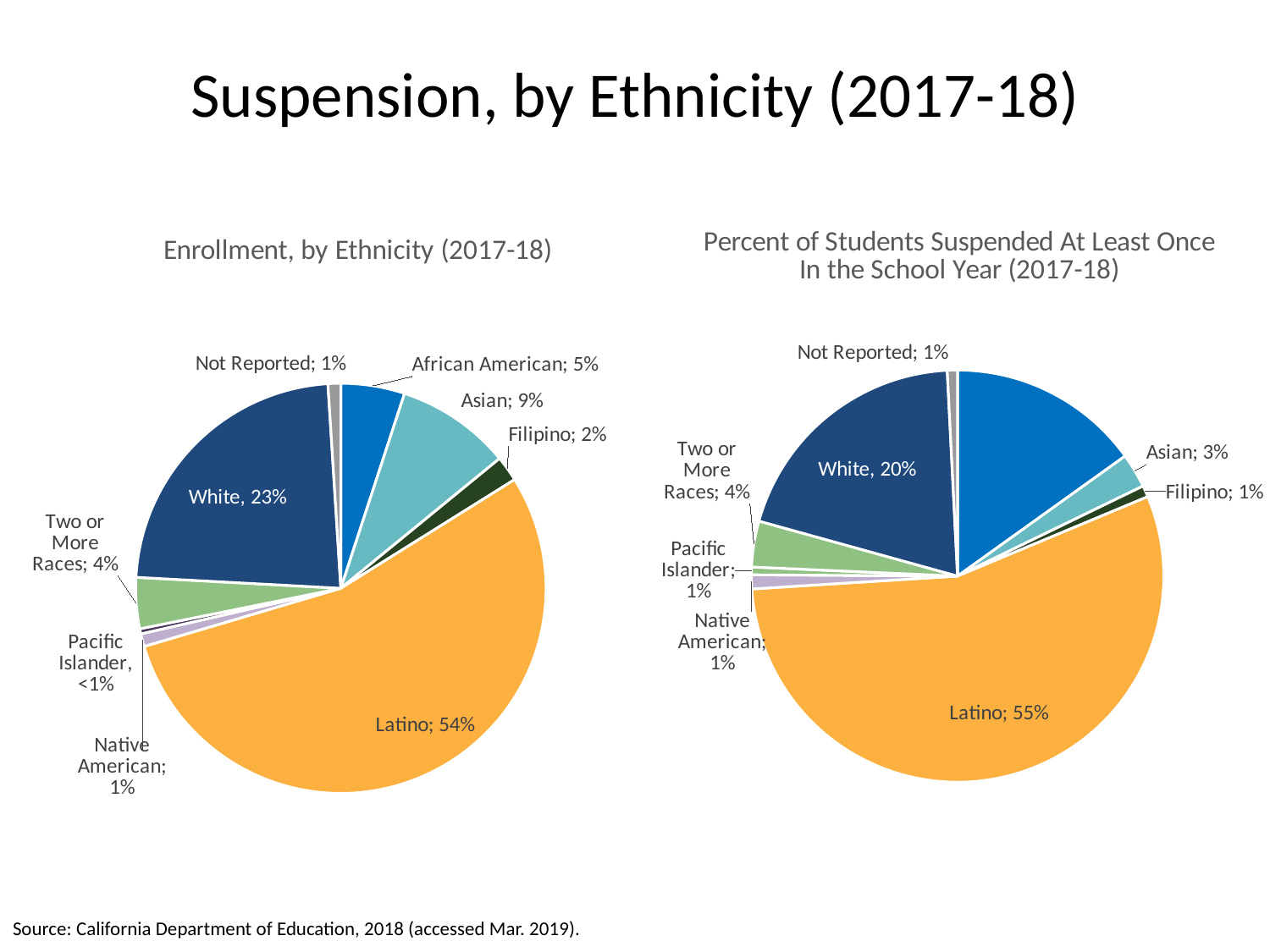
In the Enrollment, by Ethnicity (2017-18) chart, what share of enrollment is White? 23% In the Enrollment, by Ethnicity (2017-18) chart, which ethnicity has the largest slice? Latino In the Percent of Students Suspended At Least Once chart, which ethnicity has the largest slice? Latino In the Enrollment, by Ethnicity (2017-18) chart, what is the difference between the White share and the Asian share? 14% What kind of charts are shown on the slide? Pie charts In the Enrollment, by Ethnicity (2017-18) chart, which is larger, the Asian share or the Filipino share? Asian In the Enrollment, by Ethnicity (2017-18) chart, what share of enrollment is Latino? 54% In the Percent of Students Suspended At Least Once chart, what share is Asian? 3% In the Percent of Students Suspended At Least Once chart, what share is White? 20% In the Enrollment, by Ethnicity (2017-18) chart, what share of enrollment is Asian? 9% In the Enrollment, by Ethnicity (2017-18) chart, what share of enrollment is African American? 5% In the Percent of Students Suspended At Least Once chart, what share is Latino? 55%